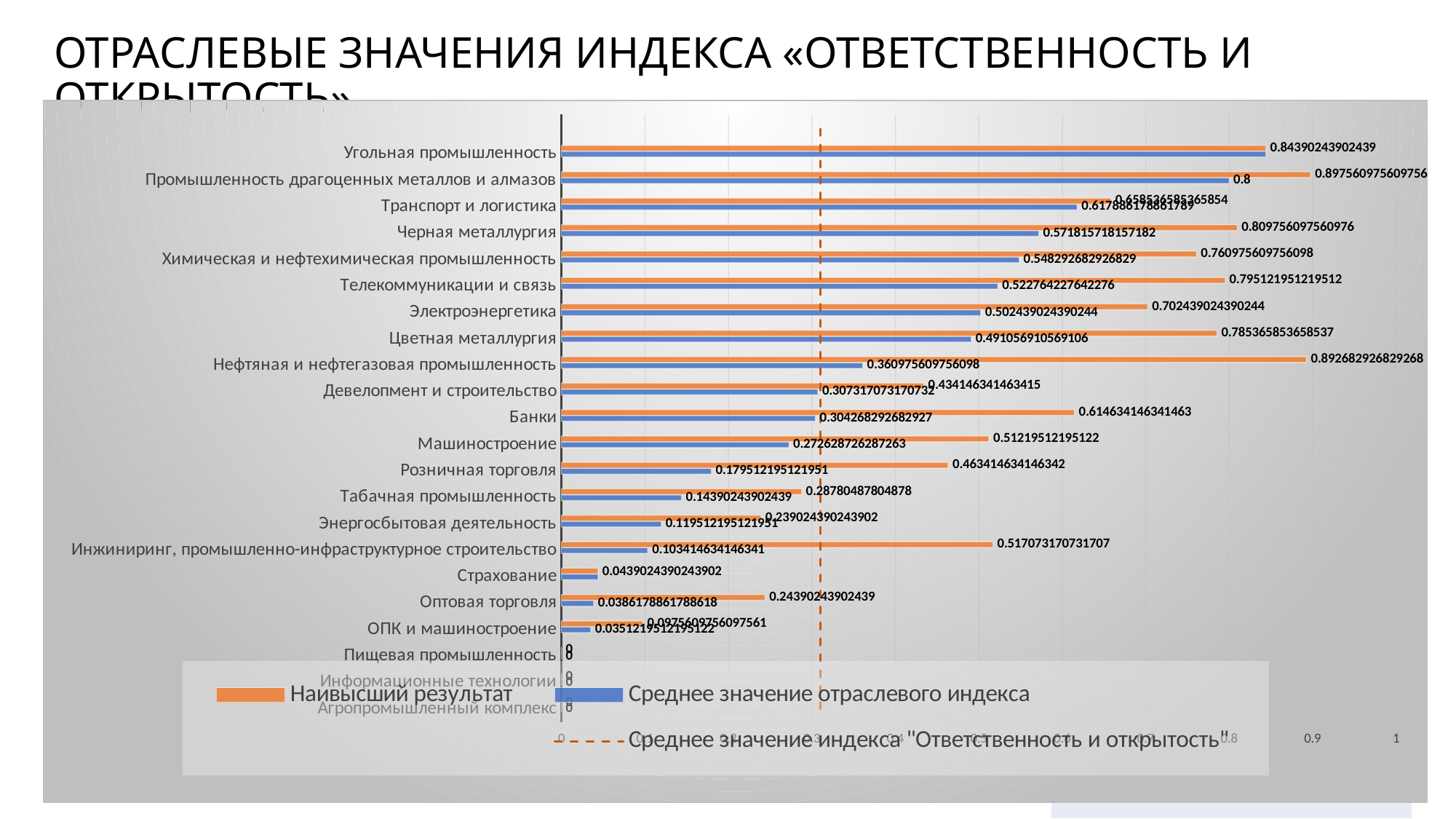
Which is larger: the «Наивысший результат» value for «Черная металлургия» or for «Телекоммуникации и связь»? Черная металлургия How many industry categories are plotted on the chart? 22 What type of chart is shown on the slide? Bar chart What is the value of «Среднее значение отраслевого индекса» for «Промышленность драгоценных металлов и алмазов»? 0.8 How many entries does the chart legend list? 3 What is the value of «Среднее значение отраслевого индекса» for «Банки»? 0.304268292682927 What is the value of «Наивысший результат» for «Нефтяная и нефтегазовая промышленность»? 0.892682926829268 What is the value of «Наивысший результат» for «Табачная промышленность»? 0.28780487804878 What colour represents «Наивысший результат» in the legend? Orange Which industry has the highest «Наивысший результат» value? Промышленность драгоценных металлов и алмазов Is the «Среднее значение отраслевого индекса» value for «Нефтяная и нефтегазовая промышленность» greater or less than 0.4? less What is the difference between «Наивысший результат» and «Среднее значение отраслевого индекса» for «Инжиниринг, промышленно-инфраструктурное строительство»? 0.413658536585366